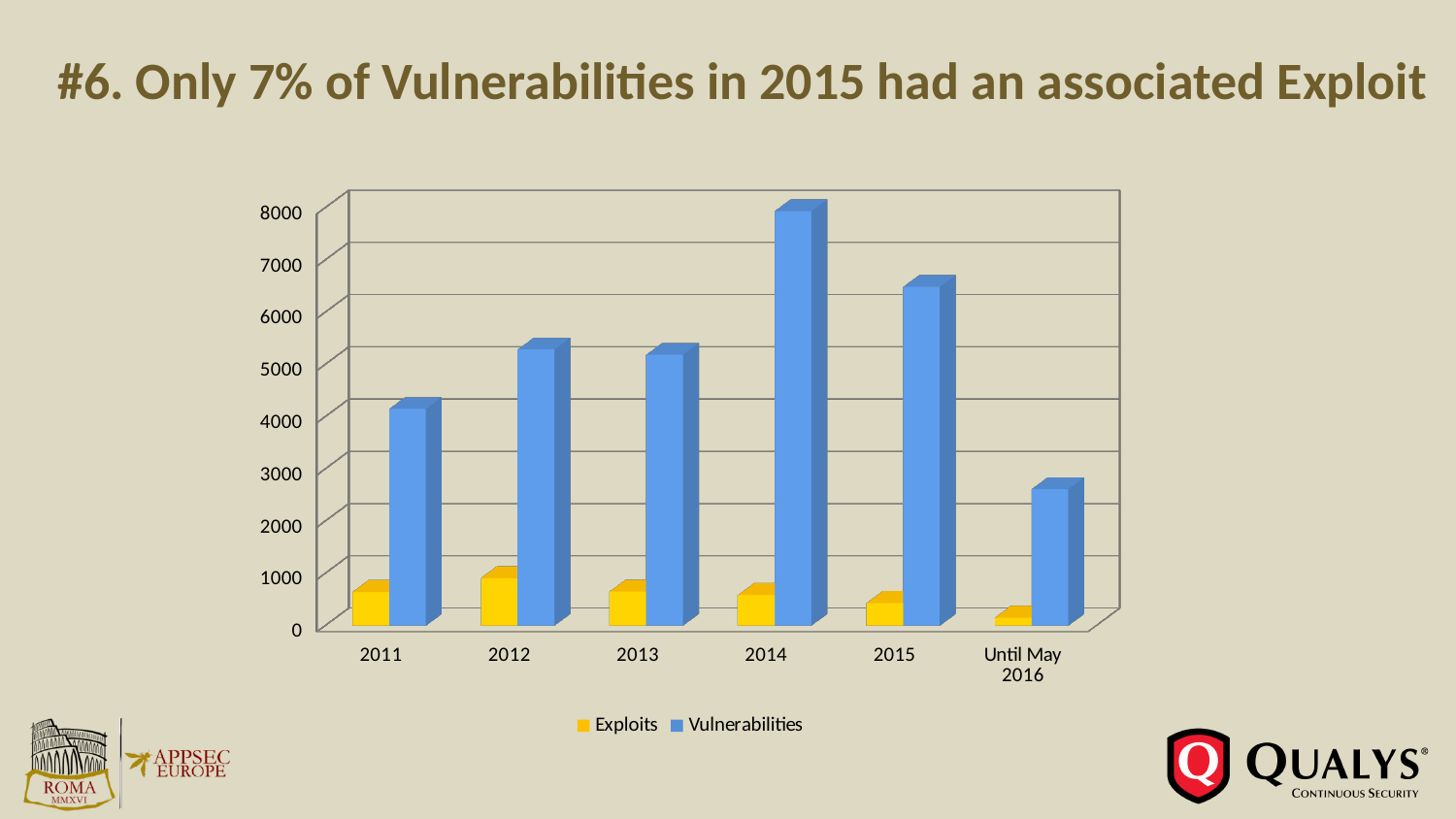
How many categories are shown on the x axis of the chart? 6 Is the value for Vulnerabilities in 2011 greater or less than 5000? less Which category has the lowest number of Exploits? Until May 2016 How many series does the chart's legend list? 2 Is the value for Exploits in 2015 greater or less than 1000? less Which is larger: Vulnerabilities in 2014 or Vulnerabilities in 2015? 2014 Which category has the lowest number of Vulnerabilities? Until May 2016 Which year has the highest number of Vulnerabilities? 2014 What kind of chart is shown on the slide? bar chart Is the value for Vulnerabilities in 2015 greater or less than 6000? greater Which year has the highest number of Exploits? 2012